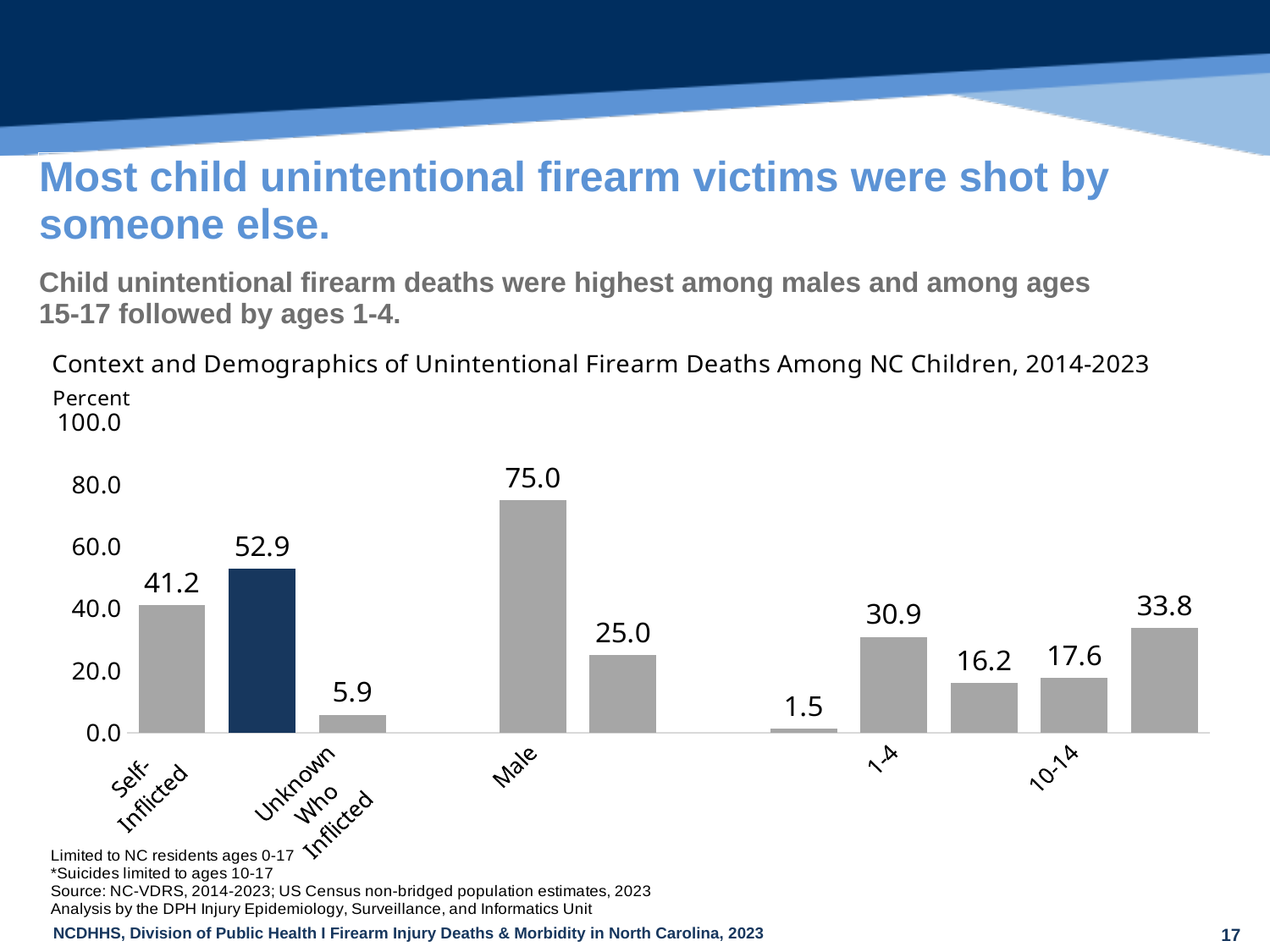
Which labeled category has the highest value? Male How many bars are plotted in the chart? 10 What kind of chart is shown on the slide? Bar chart What is the value for Self-Inflicted? 41.2 Is the value for Male greater or less than 60.0? greater What is the value for Unknown Who Inflicted? 5.9 What is the value for ages 1-4? 30.9 What is the lowest value shown on any bar in the chart? 1.5 Which is larger, the value for Self-Inflicted or for Unknown Who Inflicted? Self-Inflicted What is the value for Male? 75.0 What is the value for ages 10-14? 17.6 What is the difference between the values for Male and Self-Inflicted? 33.8